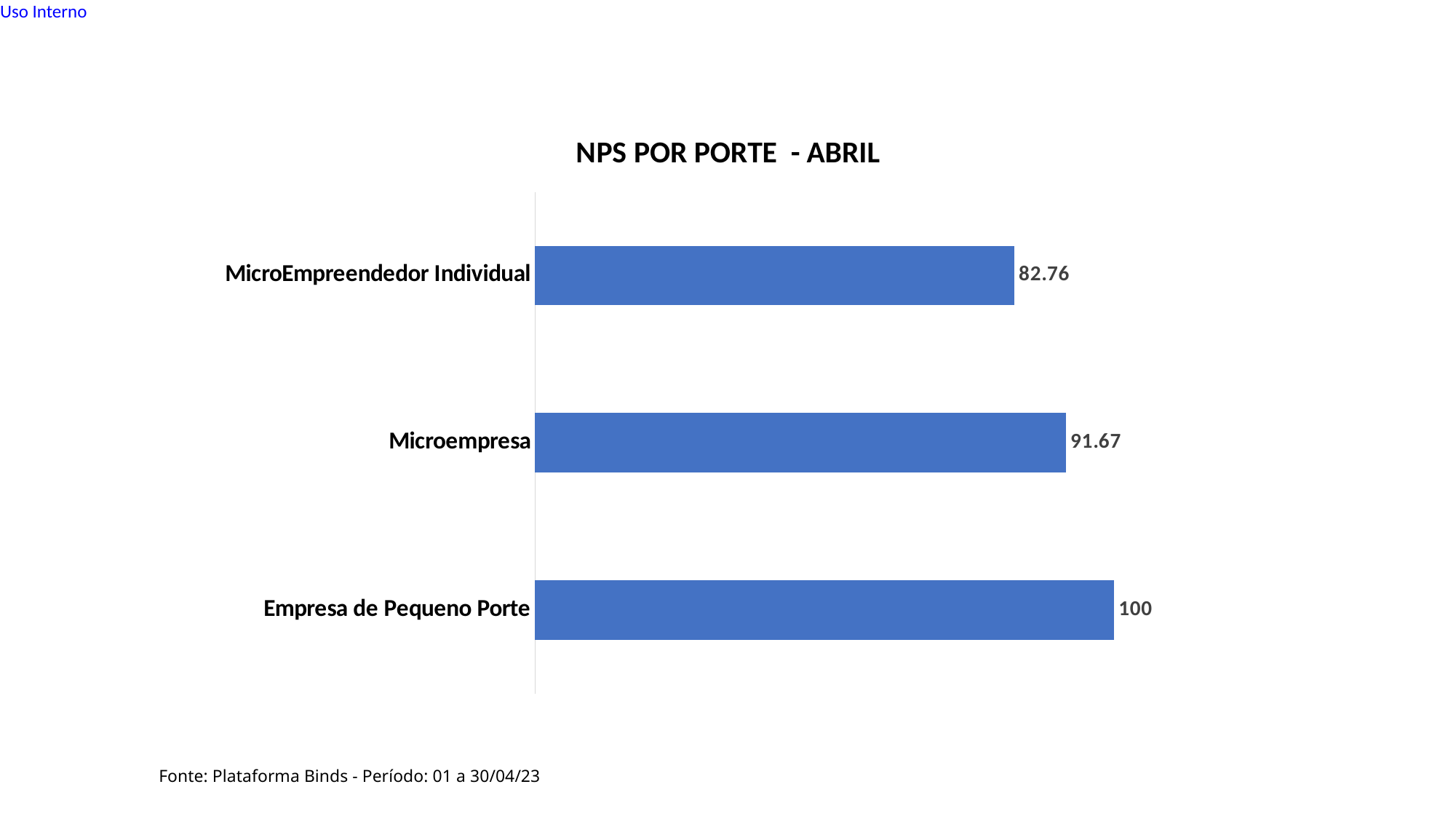
What is the source cited below the chart? Plataforma Binds - Período: 01 a 30/04/23 Which category has the highest NPS? Empresa de Pequeno Porte What kind of chart is shown on the slide? Bar chart What is the difference between the NPS of Microempresa and MicroEmpreendedor Individual? 8.91 What is the NPS value for Empresa de Pequeno Porte? 100 What is the difference between the NPS of Empresa de Pequeno Porte and Microempresa? 8.33 Which category has the lowest NPS? MicroEmpreendedor Individual What is the NPS value for Microempresa? 91.67 What is the NPS value for MicroEmpreendedor Individual? 82.76 What is the title of the chart? NPS POR PORTE - ABRIL Which has a higher NPS, Microempresa or MicroEmpreendedor Individual? Microempresa How many categories are shown in the chart? 3